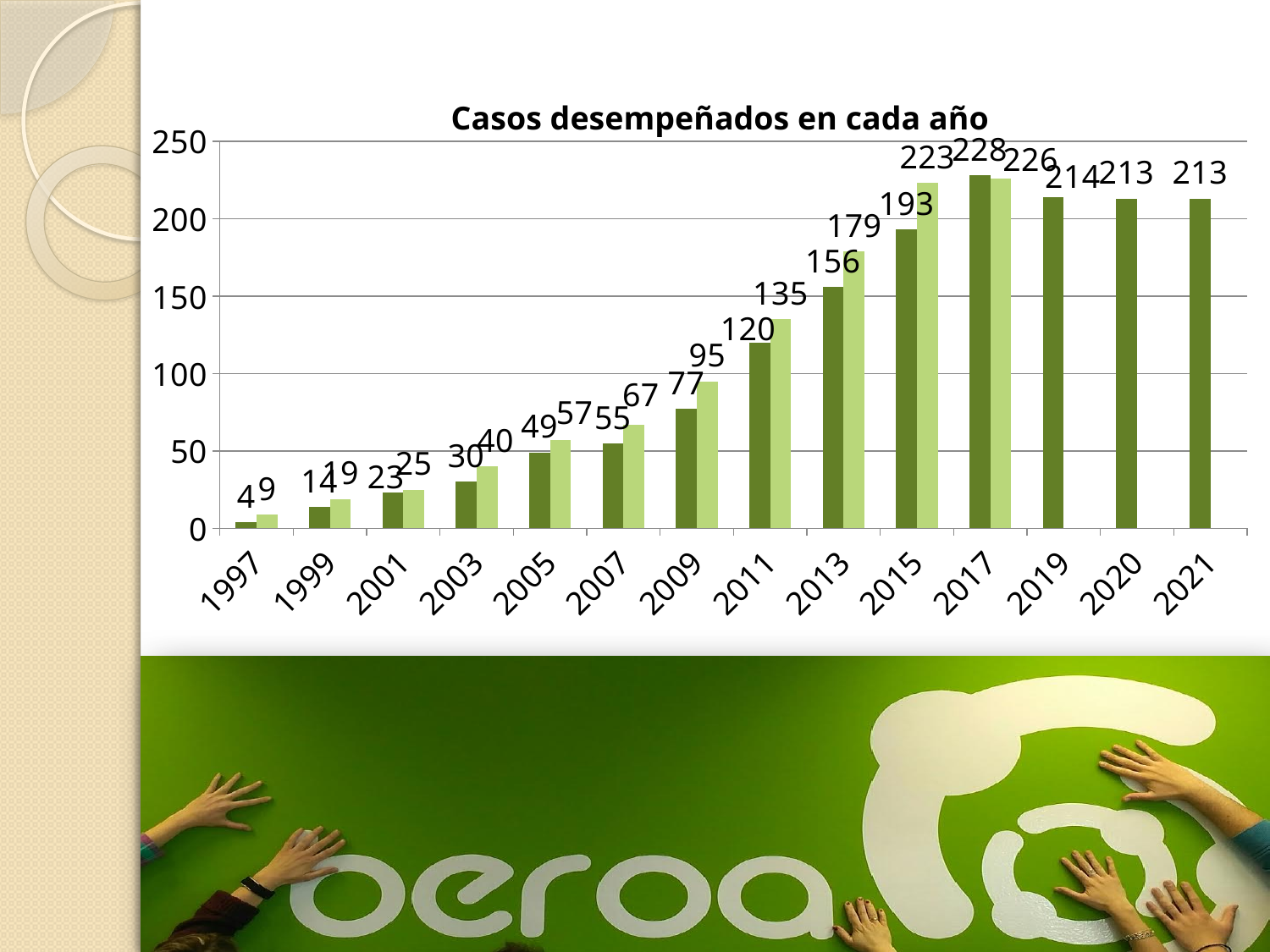
How many year labels are shown on the x axis of the chart? 14 Which is larger: the dark green bar at 2019 or the bar at 2020? 2019 What kind of chart is shown on the slide? bar chart Do the values generally rise or fall from 1997 to 2017? rise What is the title of the chart? Casos desempeñados en cada año What is the difference between the dark green bar at 2017 (228) and the dark green bar at 2015 (193)? 35 What is the value of the bar labelled 2021? 213 What is the lowest value labelled on any bar in the chart? 4 What is the value of the dark green bar at 2011? 120 Is the value of the dark green bar at 2013 greater or less than 150? greater What is the value of the dark green bar labelled 2019? 214 What is the highest value labelled on any bar in the chart? 228